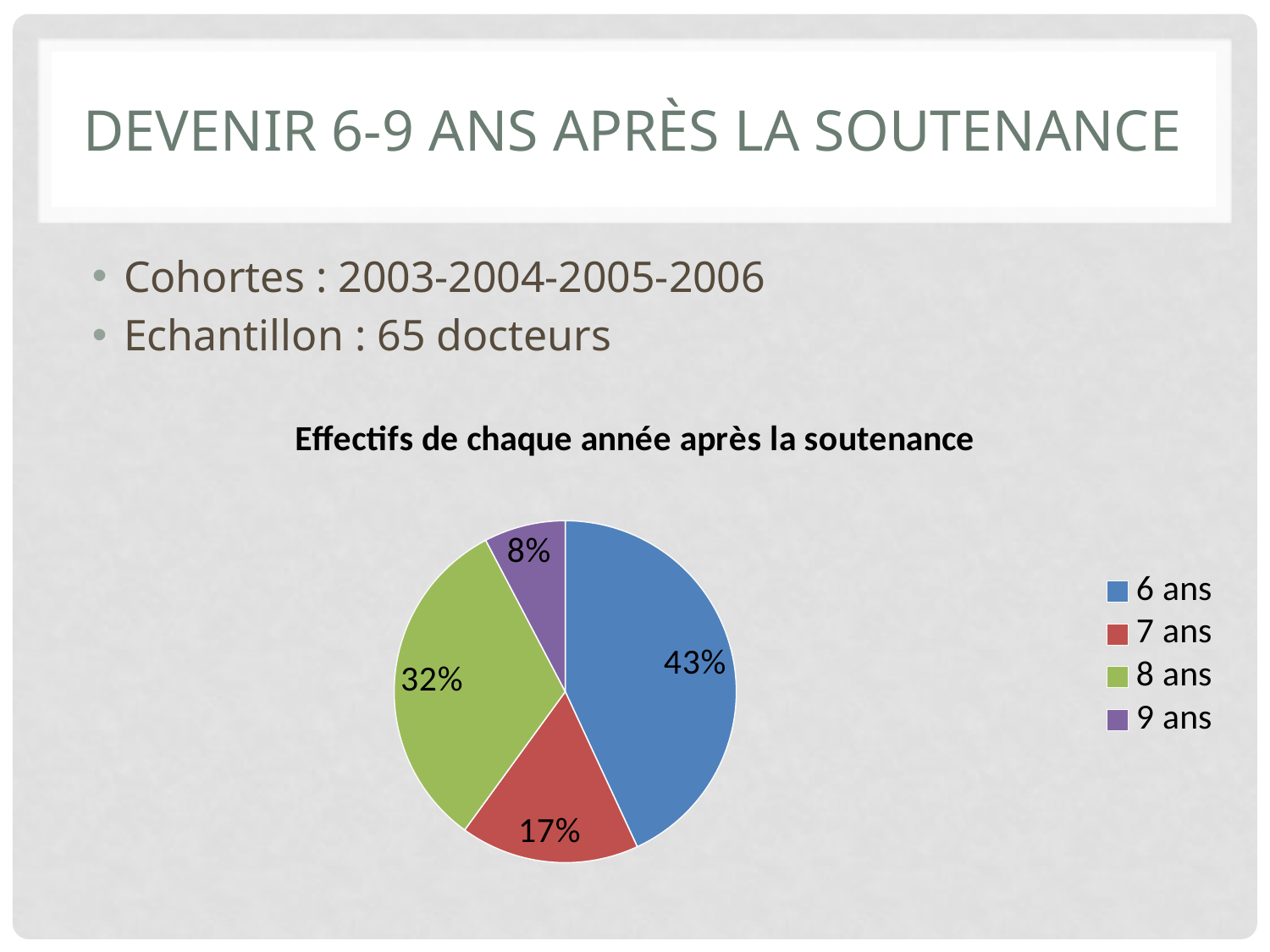
What is the title of the chart? Effectifs de chaque année après la soutenance What colour is the '8 ans' slice in the pie chart? green What share of the pie does the '6 ans' slice represent? 43% Which category has the smallest slice of the pie? 9 ans What share of the pie does the '7 ans' slice represent? 17% How many categories does the legend list? 4 What is the difference in percentage points between the '6 ans' and '8 ans' slices? 11 What type of chart is shown on the slide? pie chart What share of the pie does the '9 ans' slice represent? 8% Which slice is larger, '7 ans' or '8 ans'? 8 ans Which category has the largest slice of the pie? 6 ans